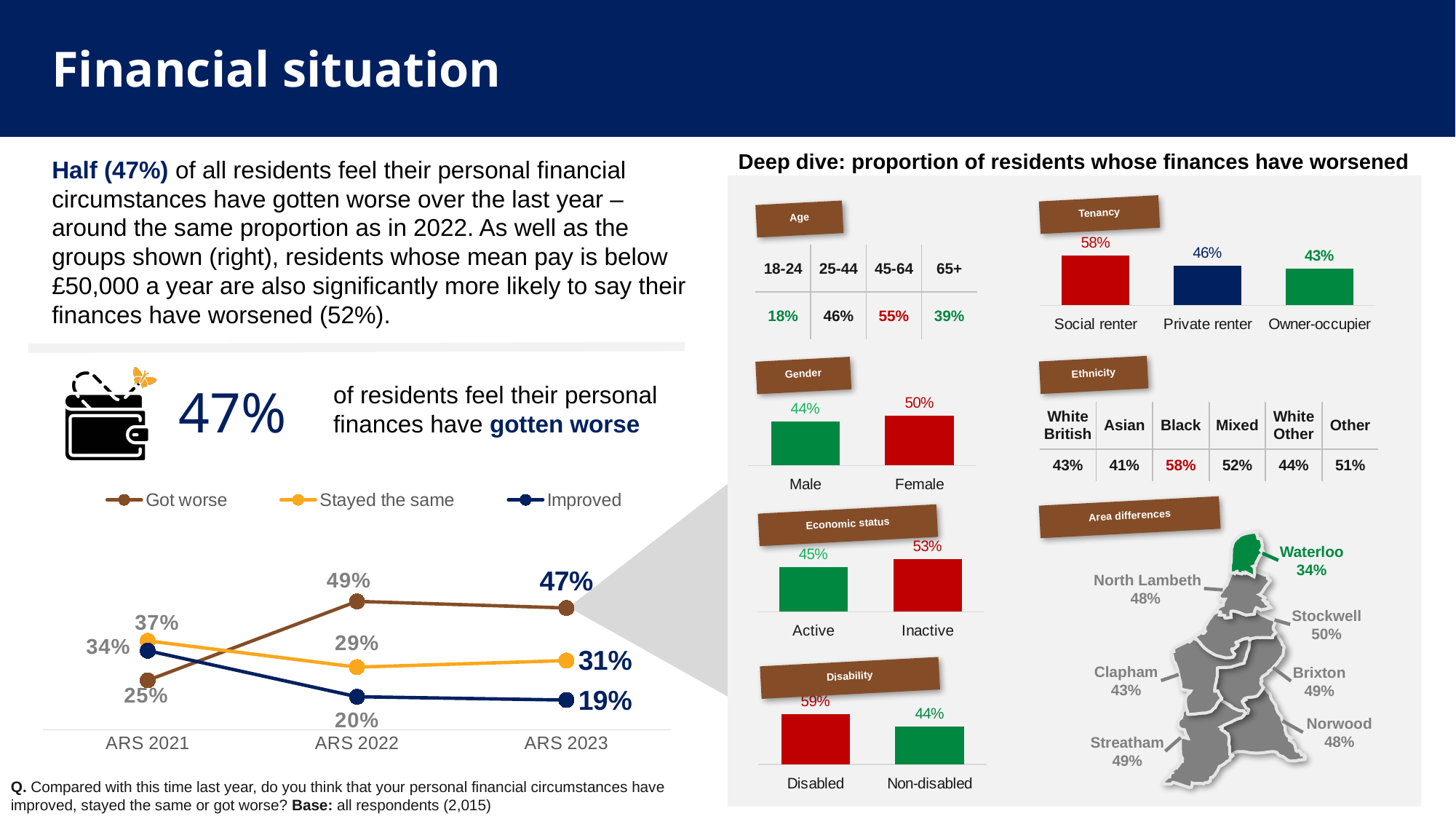
In the line chart on the left, does the 'Improved' series rise or fall from ARS 2021 to ARS 2023? Fall What type of chart is the Economic status chart on the right? Bar chart In the line chart on the left, what is the value for 'Improved' in ARS 2023? 19% In the line chart on the left, what is the difference between the 'Got worse' values for ARS 2021 and ARS 2022? 24 percentage points In the line chart on the left, what is the value for 'Stayed the same' in ARS 2021? 37% In the line chart on the left, what percentage of residents said their finances had got worse in ARS 2022? 49% In the Tenancy chart on the right, which tenancy group has the highest proportion of residents whose finances have worsened? Social renter In the Tenancy chart on the right, what is the value for Private renter? 46% In the Disability chart on the right, what is the difference between the Disabled and Non-disabled values? 15 percentage points In the line chart on the left, which series has the highest value in ARS 2023? Got worse In the line chart on the left, how many series does the legend list? 3 In the Gender chart on the right, which is larger, the value for Male or Female? Female